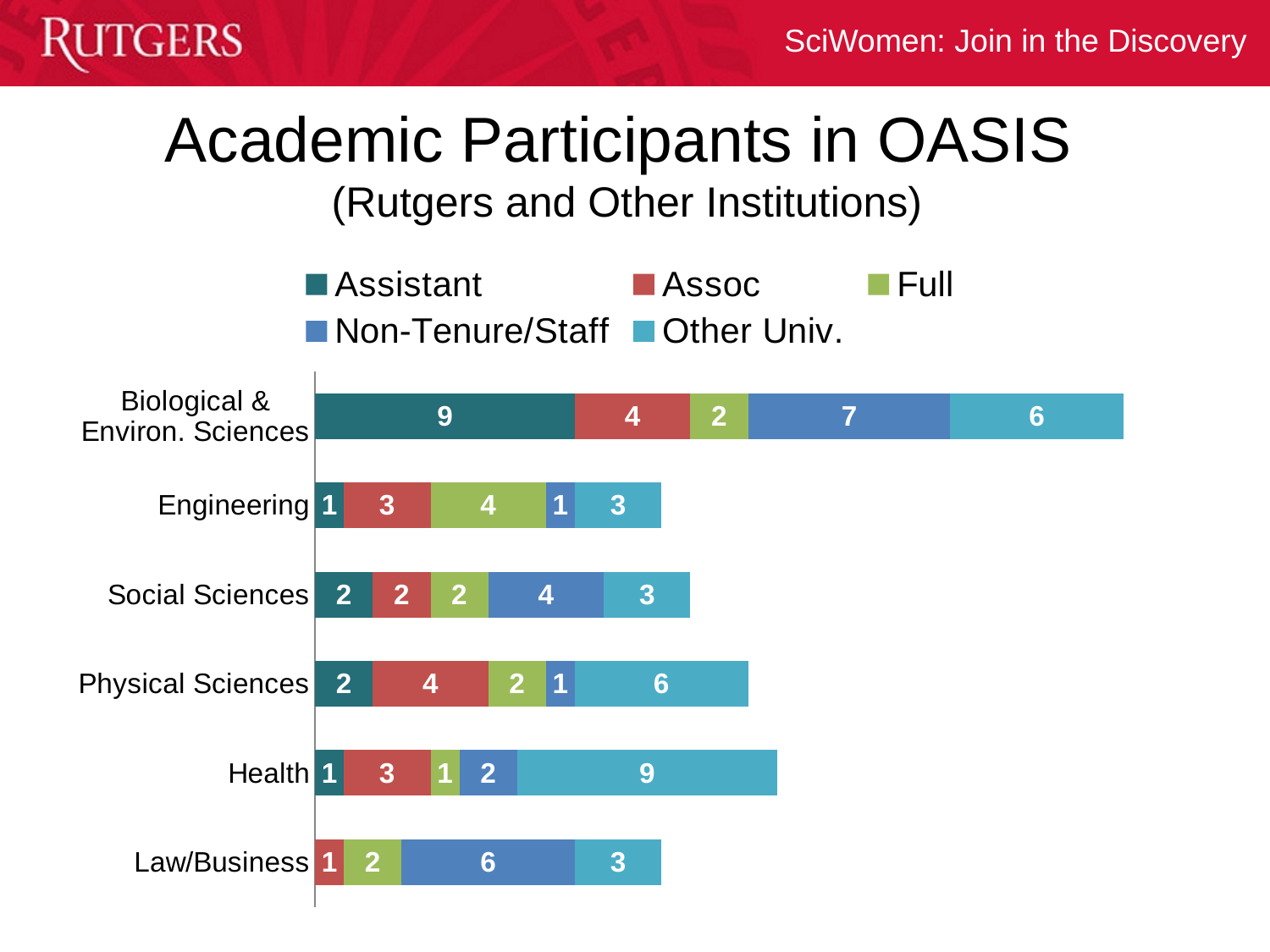
What is the Full value for Engineering? 4 What is the Non-Tenure/Staff value for Law/Business? 6 What kind of chart is shown on the slide? Stacked bar chart How many series does the legend list? 5 How many categories are shown on the chart? 6 What is the Other Univ. value for Health? 9 How many Assistant participants are shown for Biological & Environ. Sciences? 9 Which category has the longest total bar? Biological & Environ. Sciences Which is larger: the Assoc value for Physical Sciences or the Assoc value for Social Sciences? Physical Sciences What is the total of the stacked bar for Social Sciences? 13 What is the total of the stacked bar for Physical Sciences? 15 What is the difference between the Other Univ. values for Health and Engineering? 6